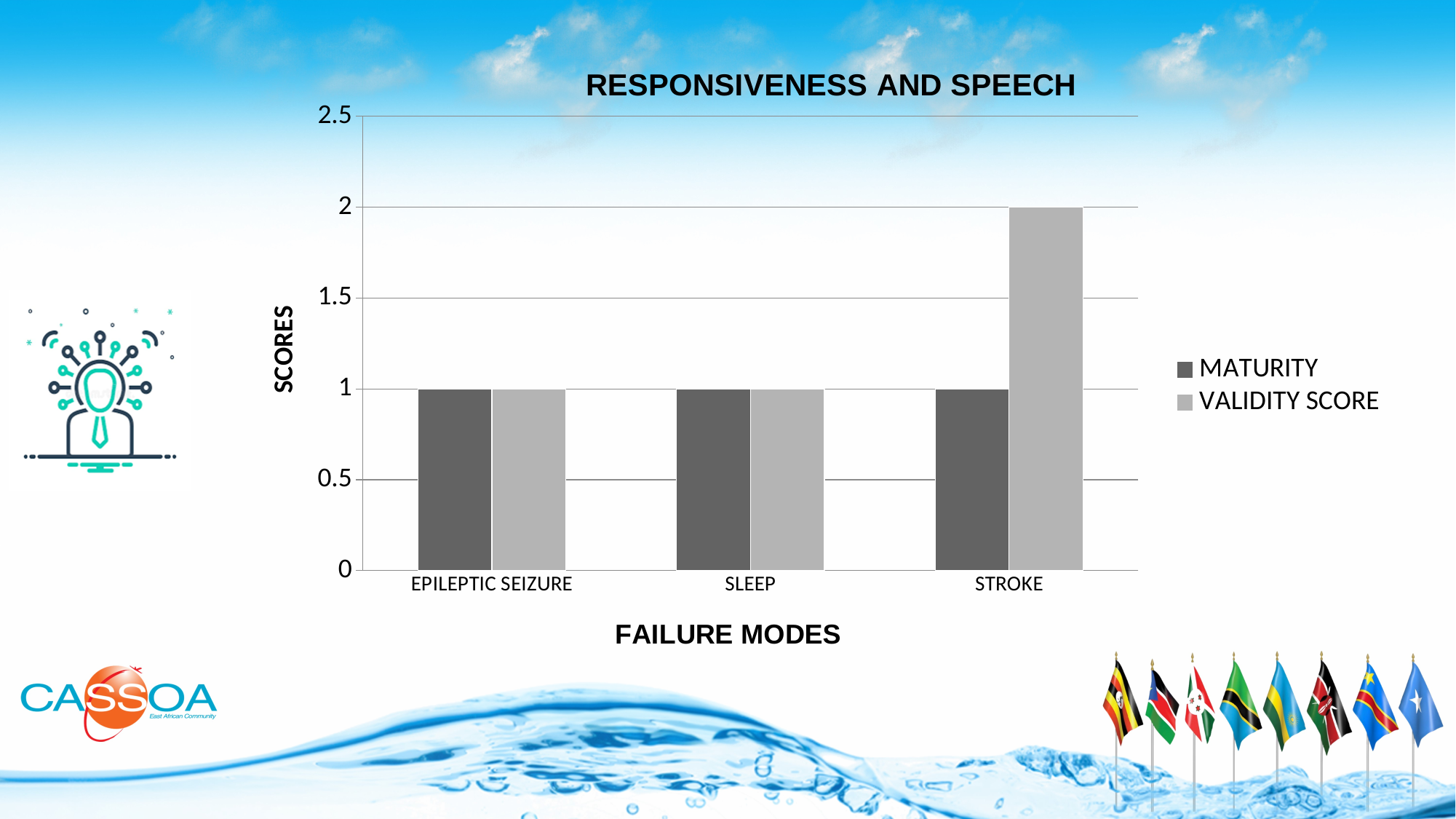
Is the VALIDITY SCORE for STROKE greater or less than 1.5? greater How many series does the legend list? 2 Which failure mode has the highest VALIDITY SCORE? STROKE What kind of chart is shown on the slide? bar chart How many failure modes are shown on the x axis? 3 What is the VALIDITY SCORE for EPILEPTIC SEIZURE? 1 What is the label of the y axis? SCORES What is the MATURITY score for SLEEP? 1 What is the title of the chart? RESPONSIVENESS AND SPEECH What is the VALIDITY SCORE for STROKE? 2 What is the difference between the VALIDITY SCORE and the MATURITY score for STROKE? 1 For STROKE, which is larger: MATURITY or VALIDITY SCORE? VALIDITY SCORE